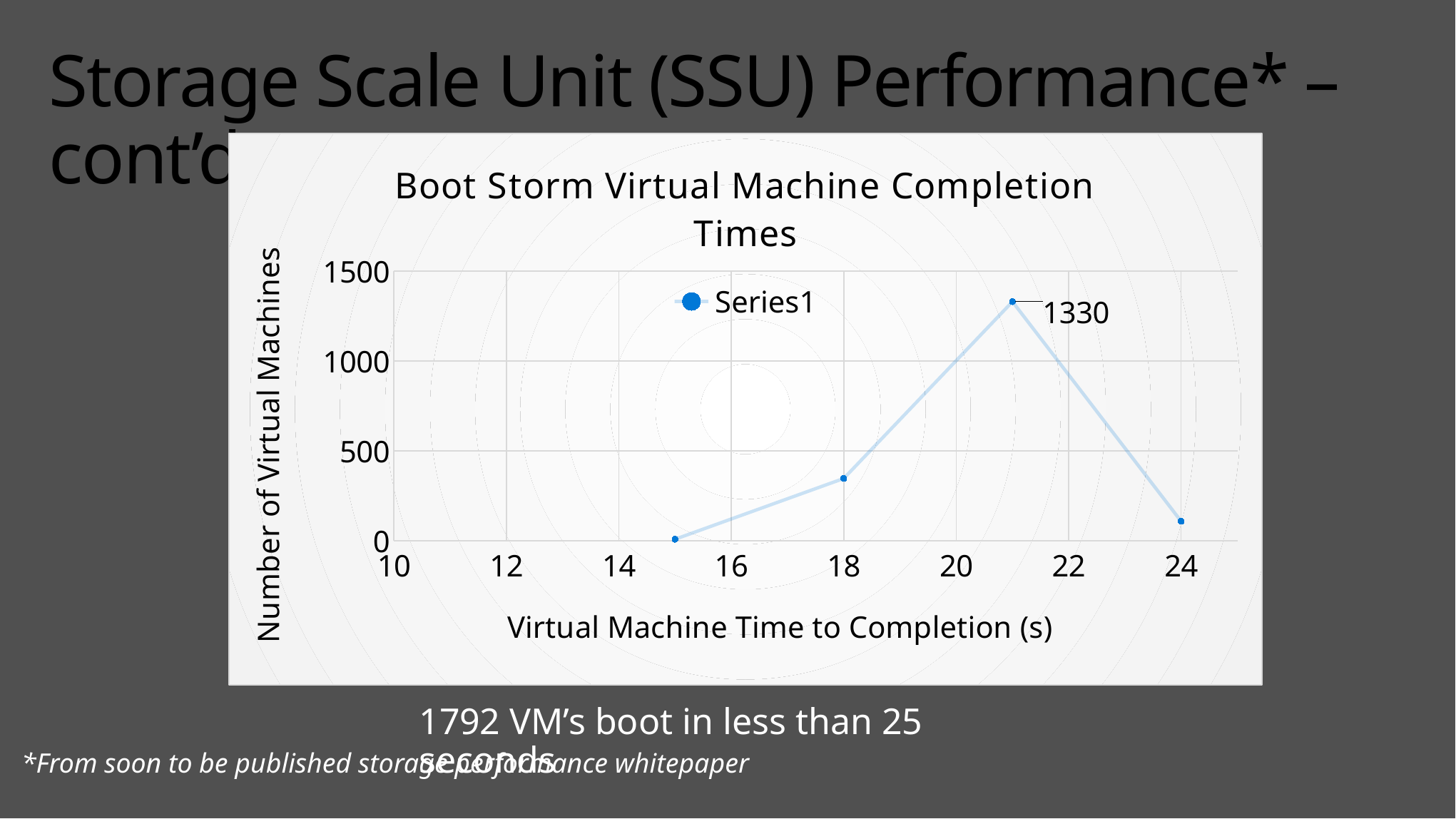
What is the label of the x axis? Virtual Machine Time to Completion (s) Is the value at 24 seconds greater or less than 500? less What is the value shown by the data label on the chart? 1330 Is the value at 18 seconds greater or less than 500? less What is the title of the chart? Boot Storm Virtual Machine Completion Times What is the highest number of virtual machines plotted on the chart? 1330 What kind of chart is shown on the slide? line chart How many data points are plotted on the chart? 4 Is the peak value on the chart greater or less than 1000? greater Do the values rise or fall between the peak and 24 seconds? fall How many series does the legend list? 1 Which has a larger number of virtual machines: the point at 18 seconds or the point at 24 seconds? 18 seconds